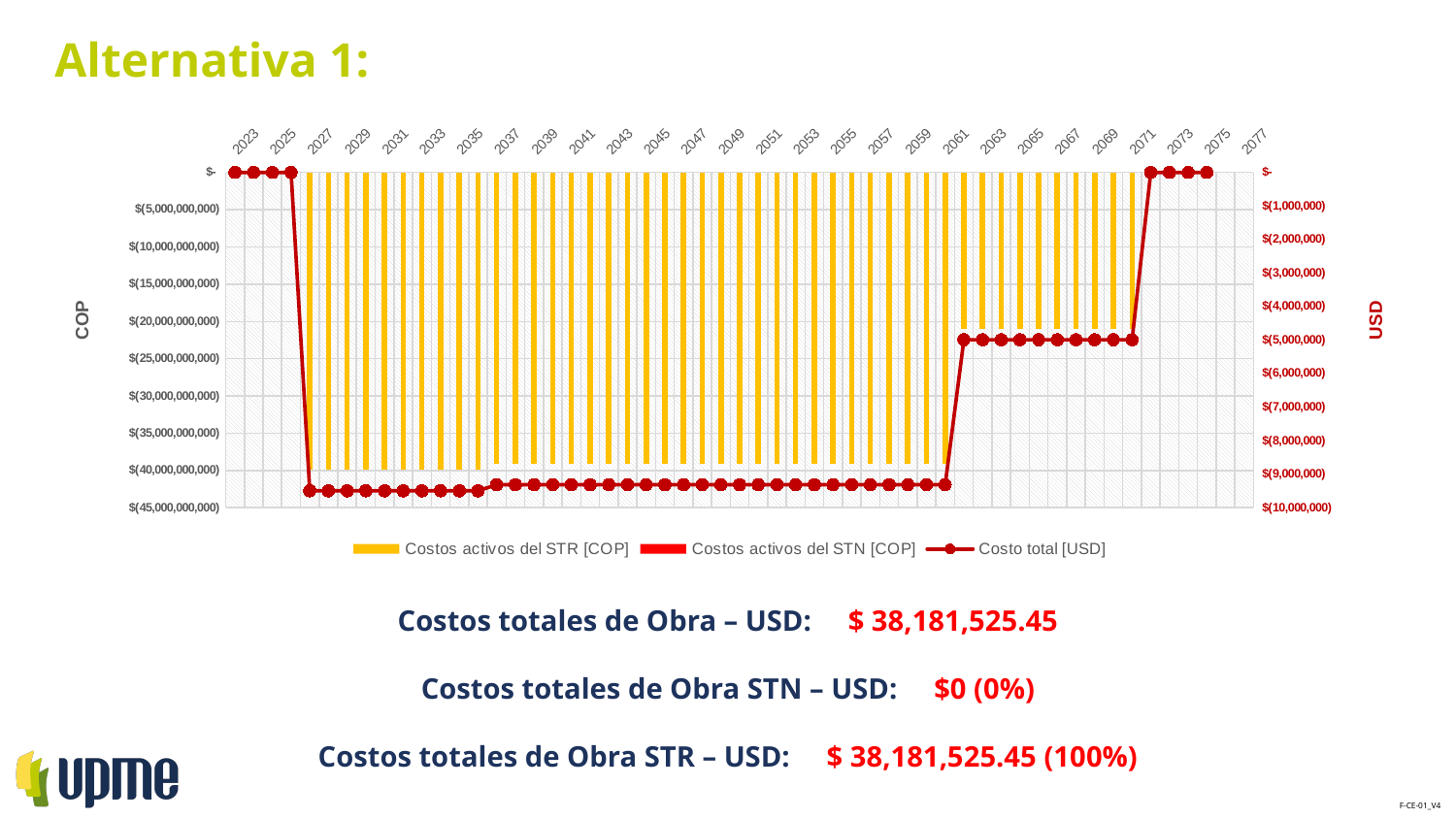
What is the first year shown on the x axis of the chart? 2023 Which is higher (closer to zero), the Costo total [USD] in 2030 or in 2065? 2065 Does the Costo total [USD] line rise or fall between 2025 and 2027? Fall How many series does the chart legend list? 3 Does the Costo total [USD] line rise or fall between 2071 and 2073? Rise What kind of chart is shown on the slide? A combined bar and line chart What is the Costo total [USD] value in 2073? $- Which bar series shows no visible bars in the chart? Costos activos del STN [COP] What is the Costo total [USD] value in 2023? $- What are the labels of the left and right vertical axes of the chart? COP (left) and USD (right) What are the three series listed in the chart legend? Costos activos del STR [COP], Costos activos del STN [COP], Costo total [USD] What is the last year shown on the x axis of the chart? 2077